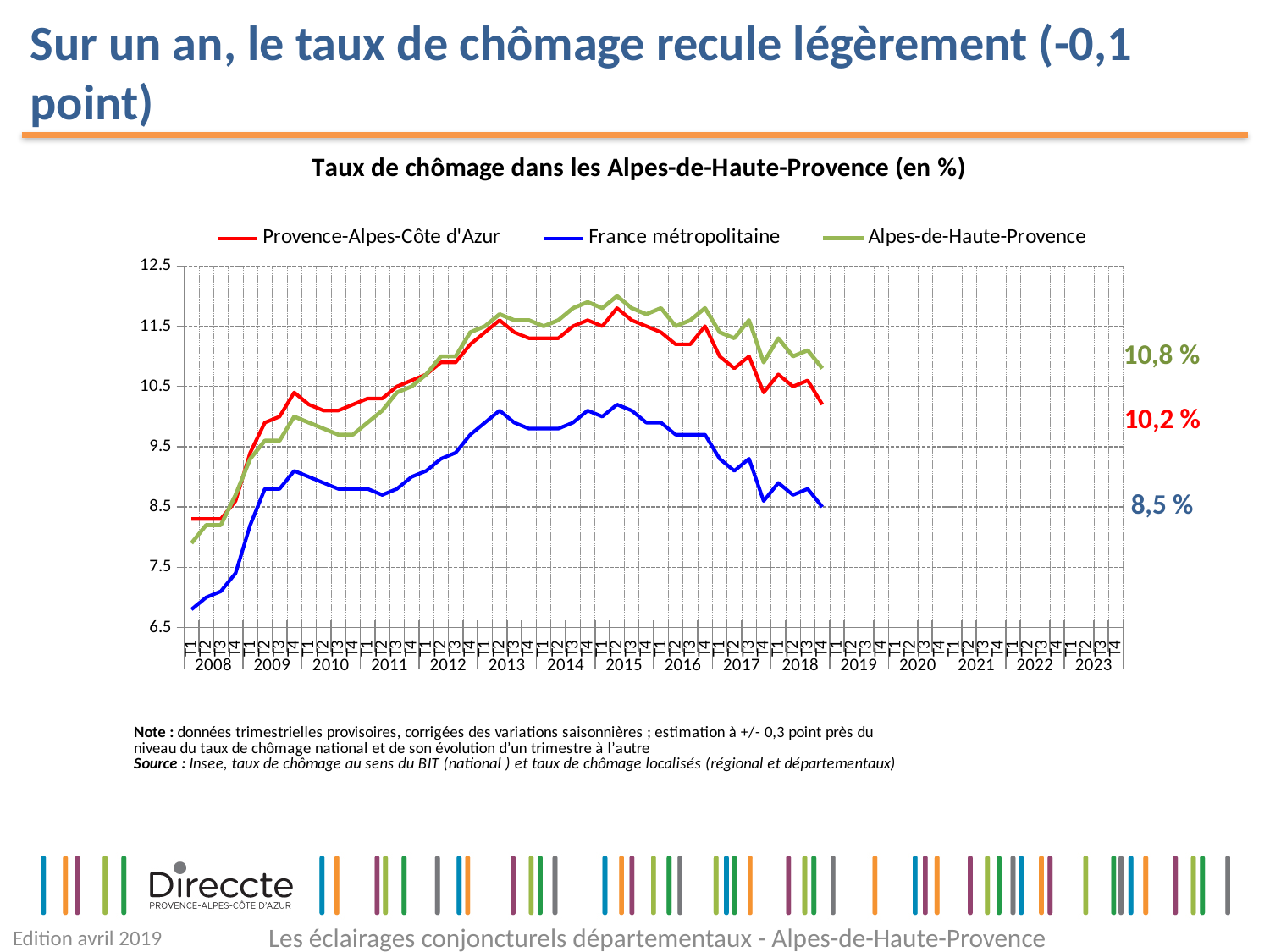
What is the latest value labelled for Provence-Alpes-Côte d'Azur? 10,2 % How many series does the legend list? 3 Which series has the lowest value at the end of the plotted period? France métropolitaine What kind of chart is shown on the slide? line chart Is the value for Alpes-de-Haute-Provence in T2 2015 greater or less than 11.5? greater What is the latest value labelled for Alpes-de-Haute-Provence? 10,8 % What is the latest value labelled for France métropolitaine? 8,5 % Is the value for France métropolitaine in T1 2008 greater or less than 7.5? less What is the difference between the latest labelled values for Alpes-de-Haute-Provence and France métropolitaine? 2,3 points Does the France métropolitaine line rise or fall between 2016 and 2018? fall Which series has the highest value at the end of the plotted period? Alpes-de-Haute-Provence What is the title of the chart? Taux de chômage dans les Alpes-de-Haute-Provence (en %)